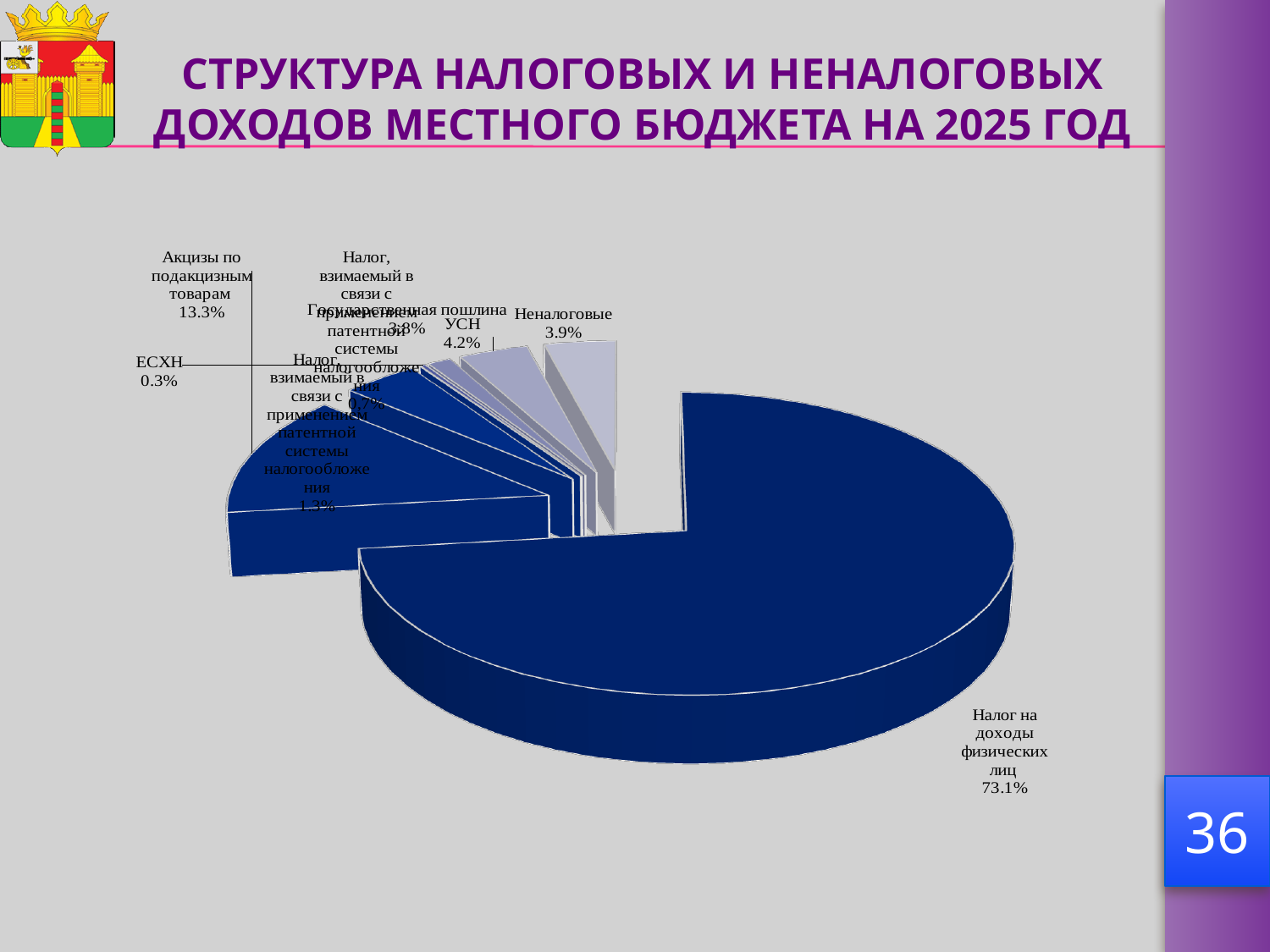
By how many percentage points does the share of Налог на доходы физических лиц exceed the share of Акцизы по подакцизным товарам? 59.8 Which revenue source has the largest share of the pie? Налог на доходы физических лиц What is the title of the slide containing the chart? СТРУКТУРА НАЛОГОВЫХ И НЕНАЛОГОВЫХ ДОХОДОВ МЕСТНОГО БЮДЖЕТА НА 2025 ГОД What percentage is shown for ЕСХН? 0.3% What percentage is shown for Неналоговые revenues? 3.9% What percentage is shown for Акцизы по подакцизным товарам? 13.3% Which has a larger share: УСН or Неналоговые? УСН What kind of chart is shown on the slide? pie chart Which has a larger share: Акцизы по подакцизным товарам or УСН? Акцизы по подакцизным товарам What percentage is shown for УСН? 4.2% What share of the local budget's tax and non-tax revenues for 2025 comes from Налог на доходы физических лиц? 73.1%